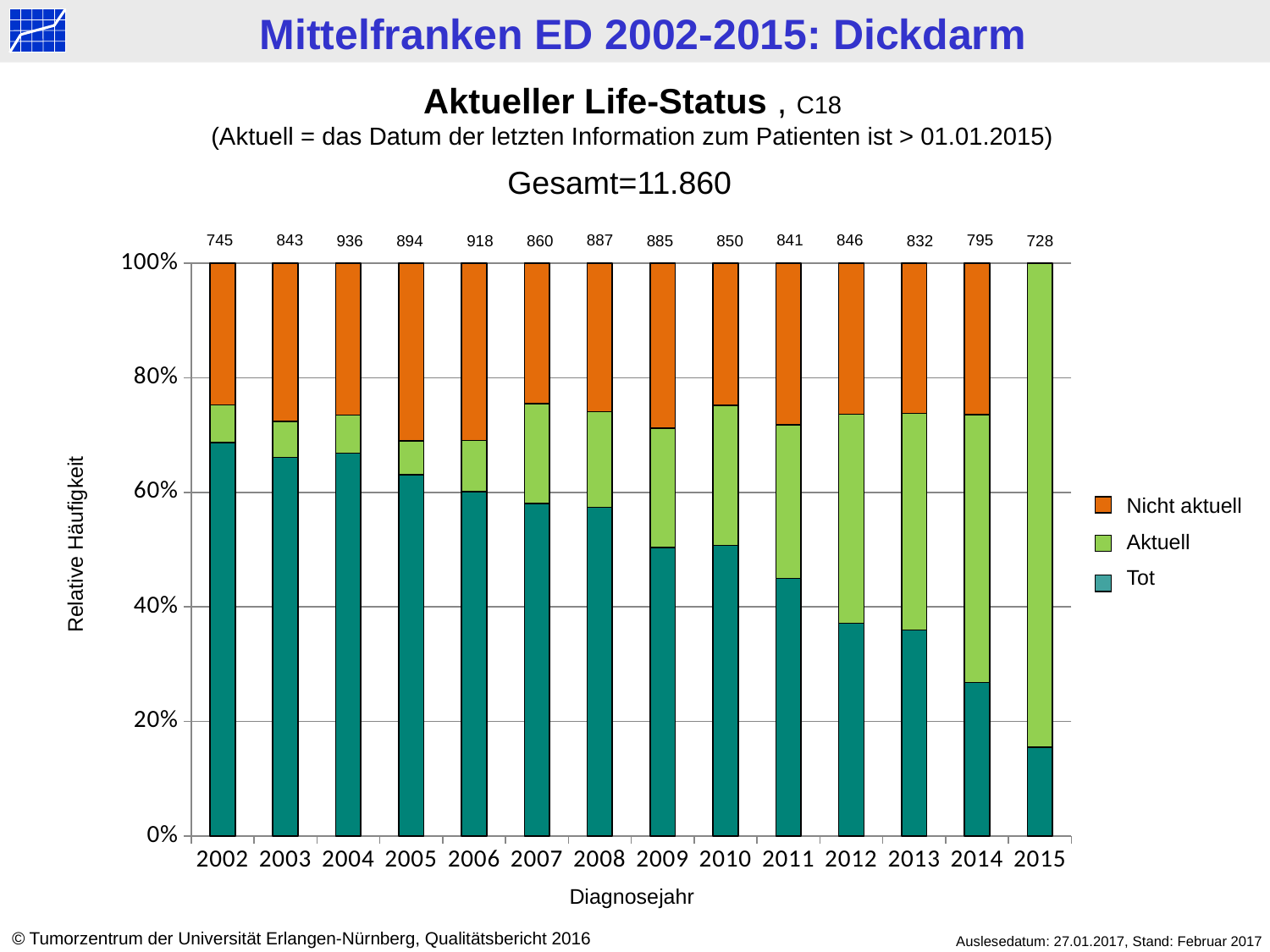
Which diagnosis year has the highest number of cases printed above its bar? 2004 How many diagnosis years (categories) are shown on the x axis? 14 Is the share of 'Tot' in 2015 greater or less than 20%? less What is the difference between the case counts printed for 2004 and 2015? 208 What is the number of cases printed above the bar for 2004? 936 Which year has more cases printed above its bar, 2006 or 2014? 2006 What is the number of cases printed above the bar for 2009? 885 Does the share of 'Tot' rise or fall from 2002 to 2015? fall How many series does the legend list? 3 What is the number of cases printed above the bar for 2015? 728 What kind of chart is shown on the slide? Stacked bar chart Which diagnosis year has the lowest number of cases printed above its bar? 2015